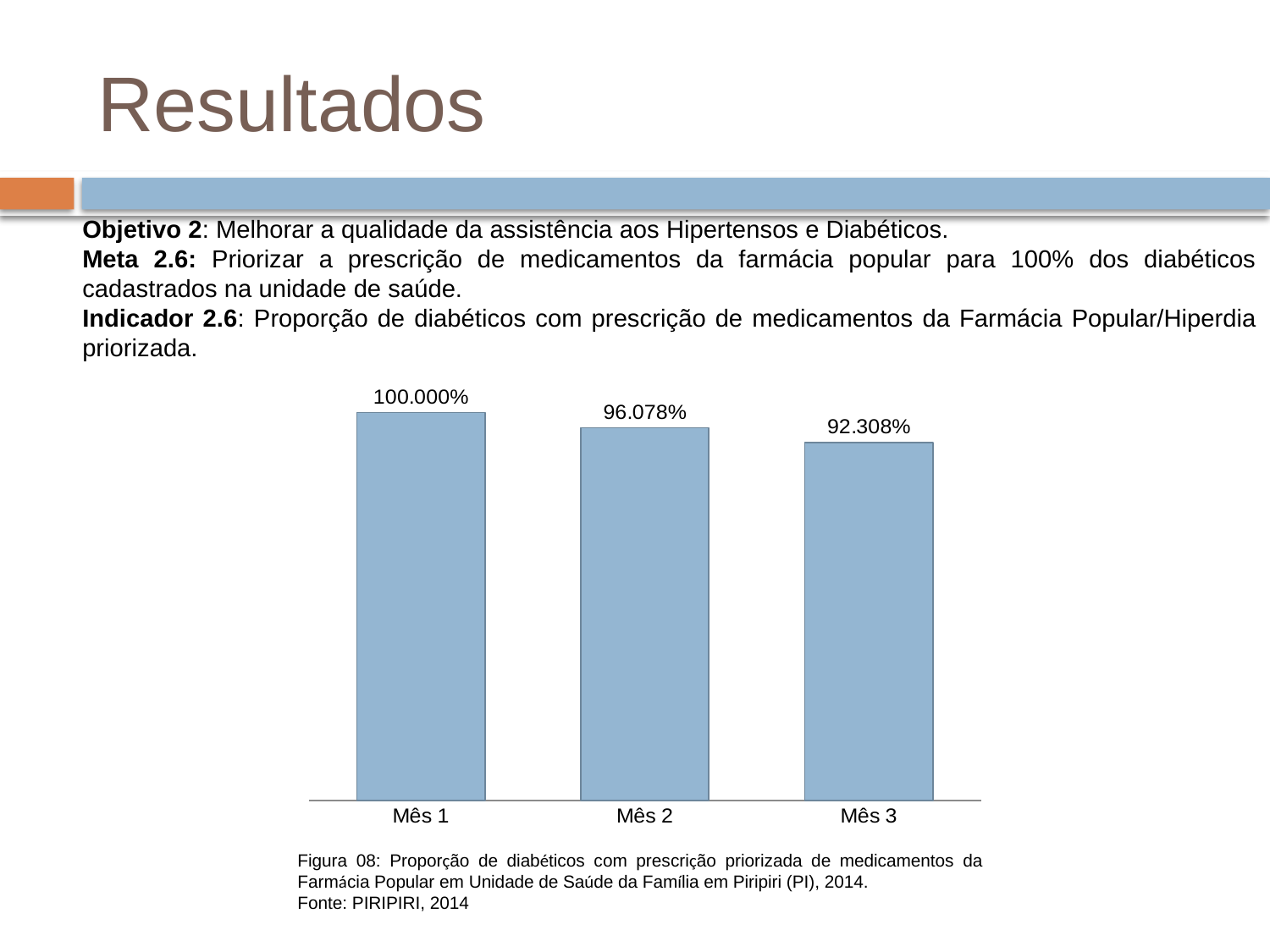
What is the difference between the values for Mês 2 and Mês 3? 3.770% What is the difference between the values for Mês 1 and Mês 3? 7.692% What is the value for Mês 3? 92.308% Do the values rise or fall from Mês 1 to Mês 3? Fall What is the figure number given in the caption below the chart? Figura 08 What kind of chart is shown on the slide? Bar chart Which is larger, the value for Mês 2 or the value for Mês 3? Mês 2 Which month has the highest value? Mês 1 What is the value for Mês 1? 100.000% How many months are shown on the chart? 3 Which month has the lowest value? Mês 3 What is the value for Mês 2? 96.078%